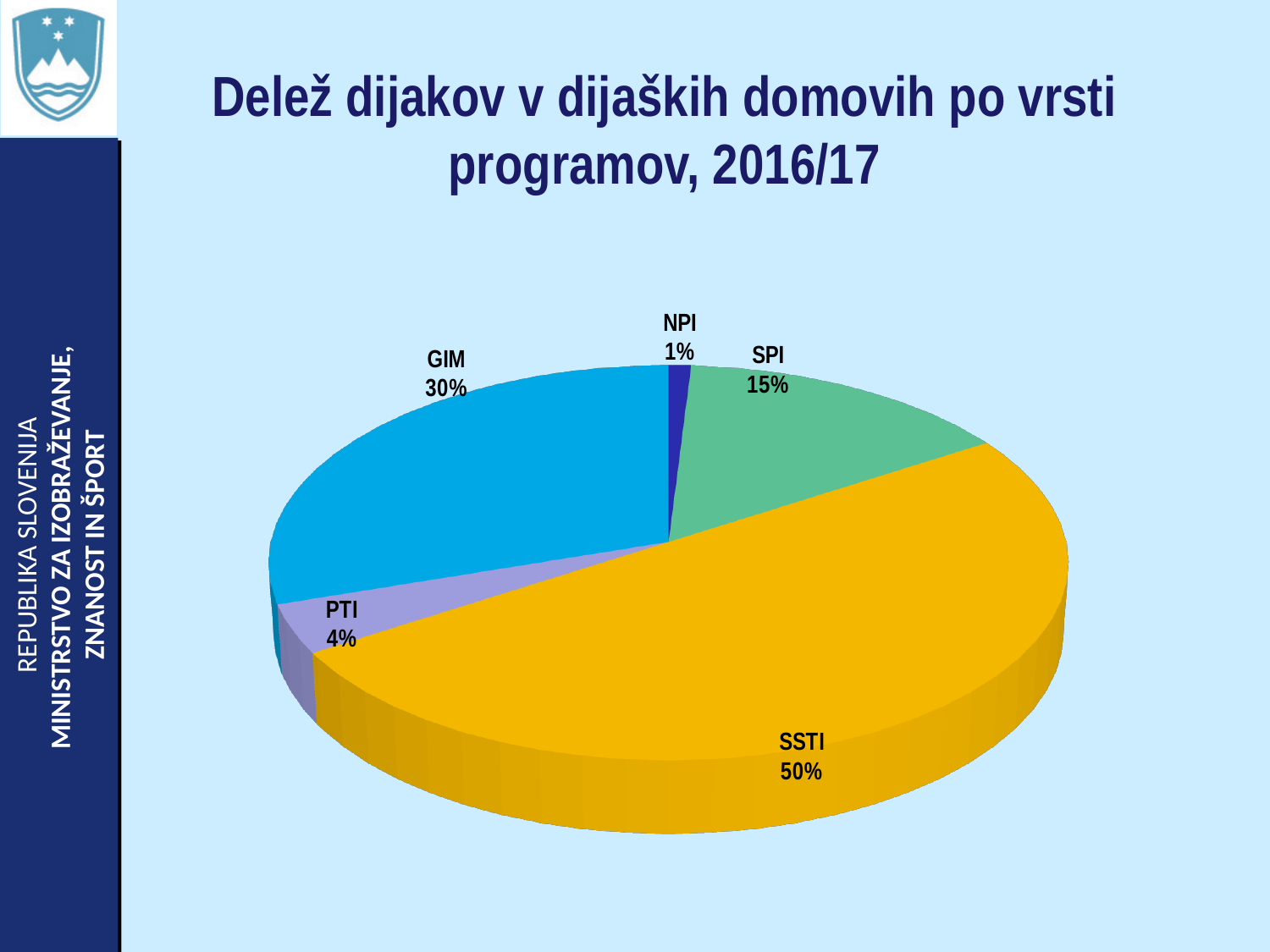
What is the value shown for SPI? 15% What share of the pie does SSTI have? 50% What is the value shown for NPI? 1% What is the title of the chart on the slide? Delež dijakov v dijaških domovih po vrsti programov, 2016/17 Which category has the largest share of the pie? SSTI Which is larger, the share for SPI or the share for PTI? SPI Which category has the smallest share of the pie? NPI How many slices does the pie chart have? 5 What is the difference between the shares of SSTI and GIM? 20% What is the value shown for PTI? 4% What type of chart is shown on the slide? pie chart What is the value shown for GIM? 30%